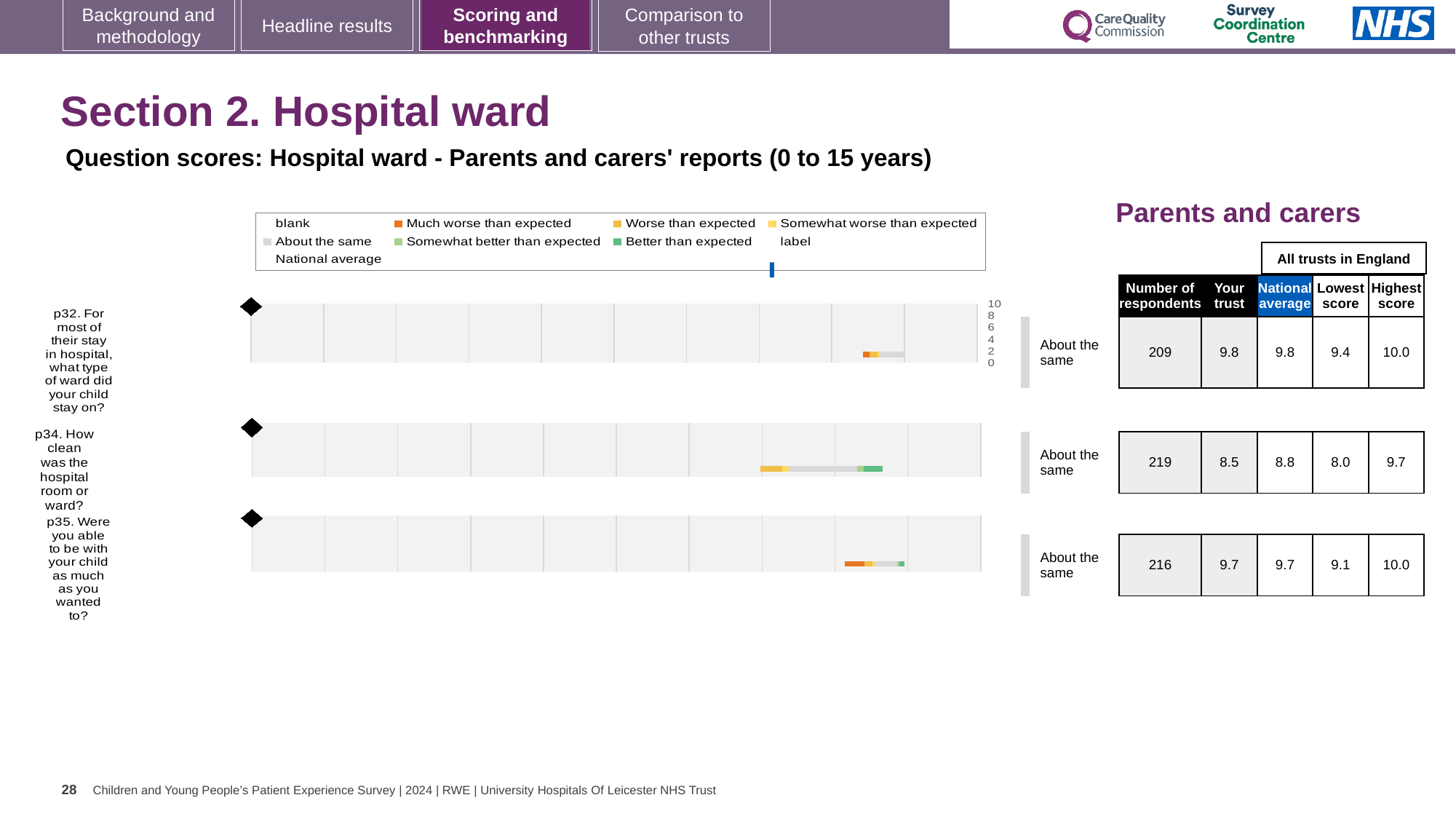
What kind of chart is used to show the question scores? Bar chart How many questions are charted on this slide? 3 How many respondents are listed for question p34 (How clean was the hospital room or ward?)? 219 What is the national average score for question p34? 8.8 What is the 'Your trust' score for question p32 (what type of ward did your child stay on)? 9.8 Which question has the highest 'Your trust' score? p32 Which question has the lowest 'Your trust' score? p34 What is the highest score across all trusts in England for question p34? 9.7 What benchmark category is shown next to the chart for question p35? About the same What is the lowest score across all trusts in England for question p35? 9.1 For question p34, which is larger: the 'Your trust' score or the national average? National average What is the difference between the highest score and the lowest score for question p34? 1.7